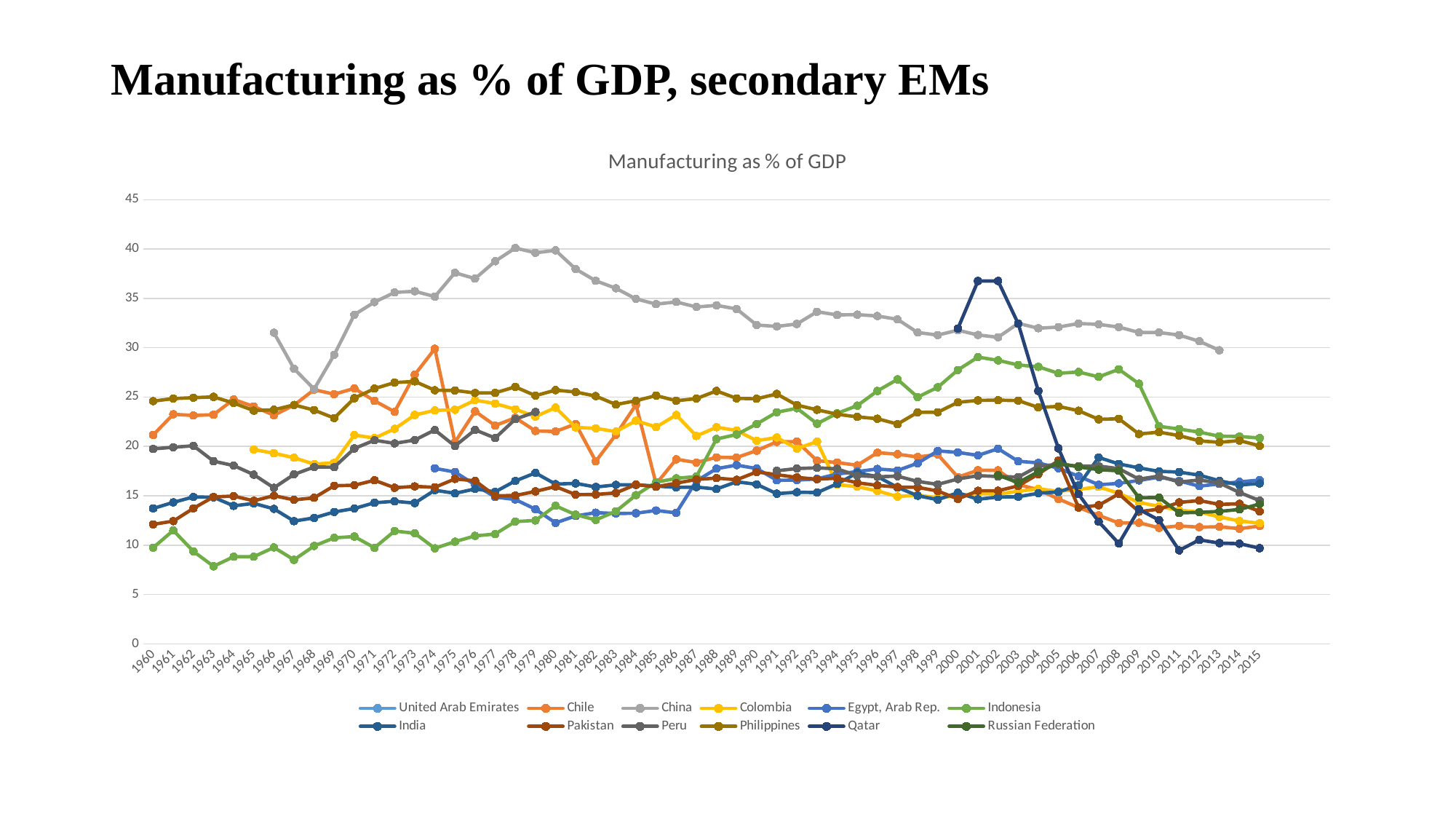
In 2015, which is larger: the value for Indonesia or the value for Pakistan? Indonesia What is the title of the chart? Manufacturing as % of GDP How many years are shown along the x axis? 56 Is the value for Philippines in 1960 greater or less than 20? greater How many series does the legend list? 12 Which series has the highest value in 1978? China Is the value for Indonesia in 1963 greater or less than 10? less Does the value for China rise or fall overall from 1978 to 2013? fall Is the value for Qatar in 2001 greater or less than 35? greater What kind of chart is shown on the slide? line chart Which series has the lowest value in 1963? Indonesia